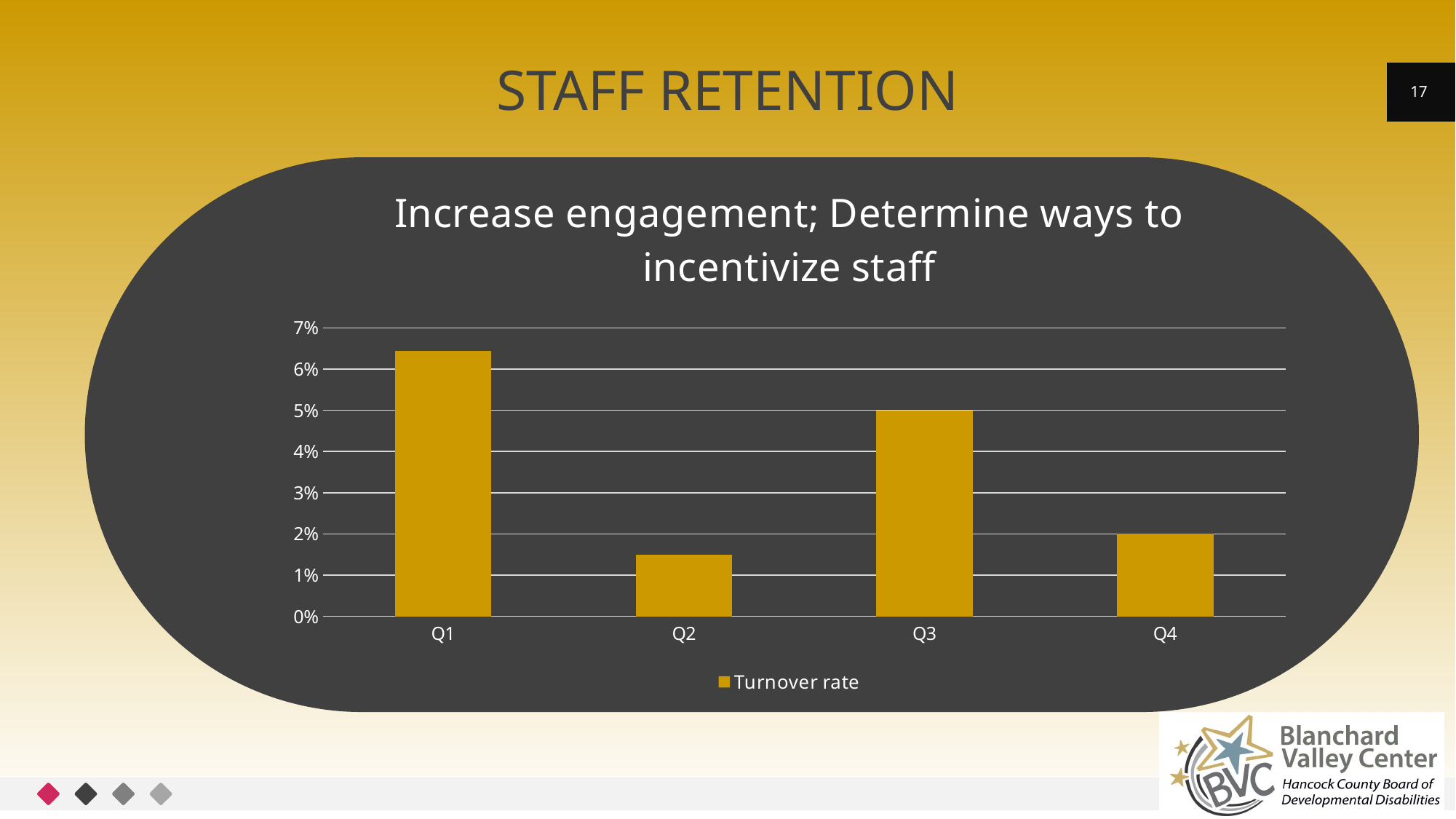
How many series does the chart legend list? 1 What is the turnover rate for Q3? 5% How many categories are shown on the x axis of the chart? 4 Which quarter has the highest turnover rate? Q1 Which quarter has the lowest turnover rate? Q2 Is the turnover rate for Q2 greater or less than 2%? less What is the turnover rate for Q4? 2% What is the difference between the turnover rates for Q3 and Q4? 3% What type of chart is shown on the slide? bar chart Which quarter has a higher turnover rate, Q3 or Q4? Q3 Is the turnover rate for Q1 greater or less than 6%? greater What is the name of the series shown in the chart legend? Turnover rate